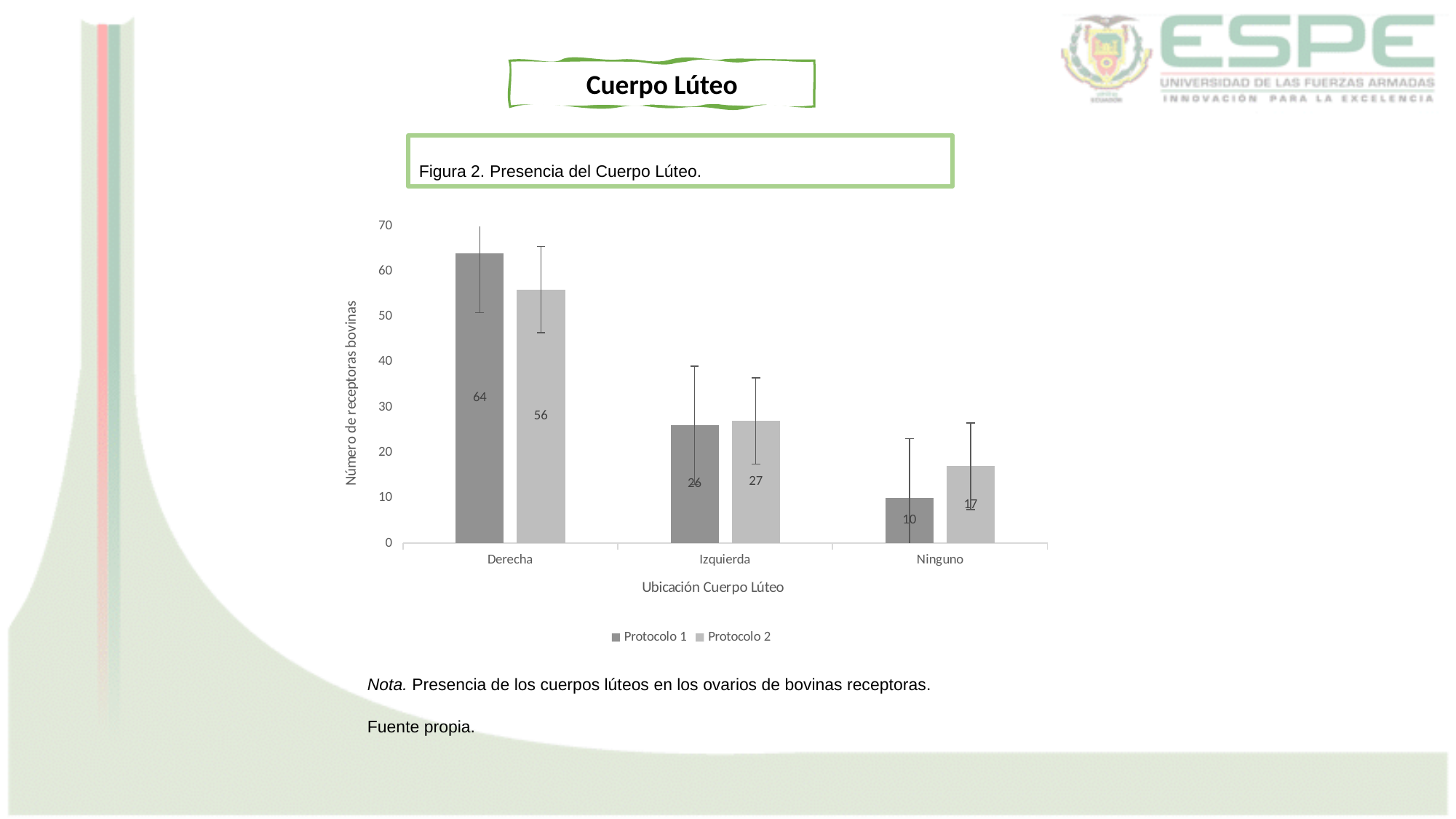
How many categories are shown on the x axis? 3 Which is larger in the Ninguno category, Protocolo 1 or Protocolo 2? Protocolo 2 What is the value for Protocolo 1 in the Derecha category? 64 What is the label of the y axis? Número de receptoras bovinas What is the value for Protocolo 2 in the Izquierda category? 27 Which category has the lowest value for Protocolo 2? Ninguno What is the difference between Protocolo 1 and Protocolo 2 in the Derecha category? 8 Is the value for Protocolo 2 in the Derecha category greater or less than 50? greater What is the value for Protocolo 2 in the Ninguno category? 17 What kind of chart is shown on the slide? bar chart How many series does the legend list? 2 Which category has the highest value for Protocolo 1? Derecha